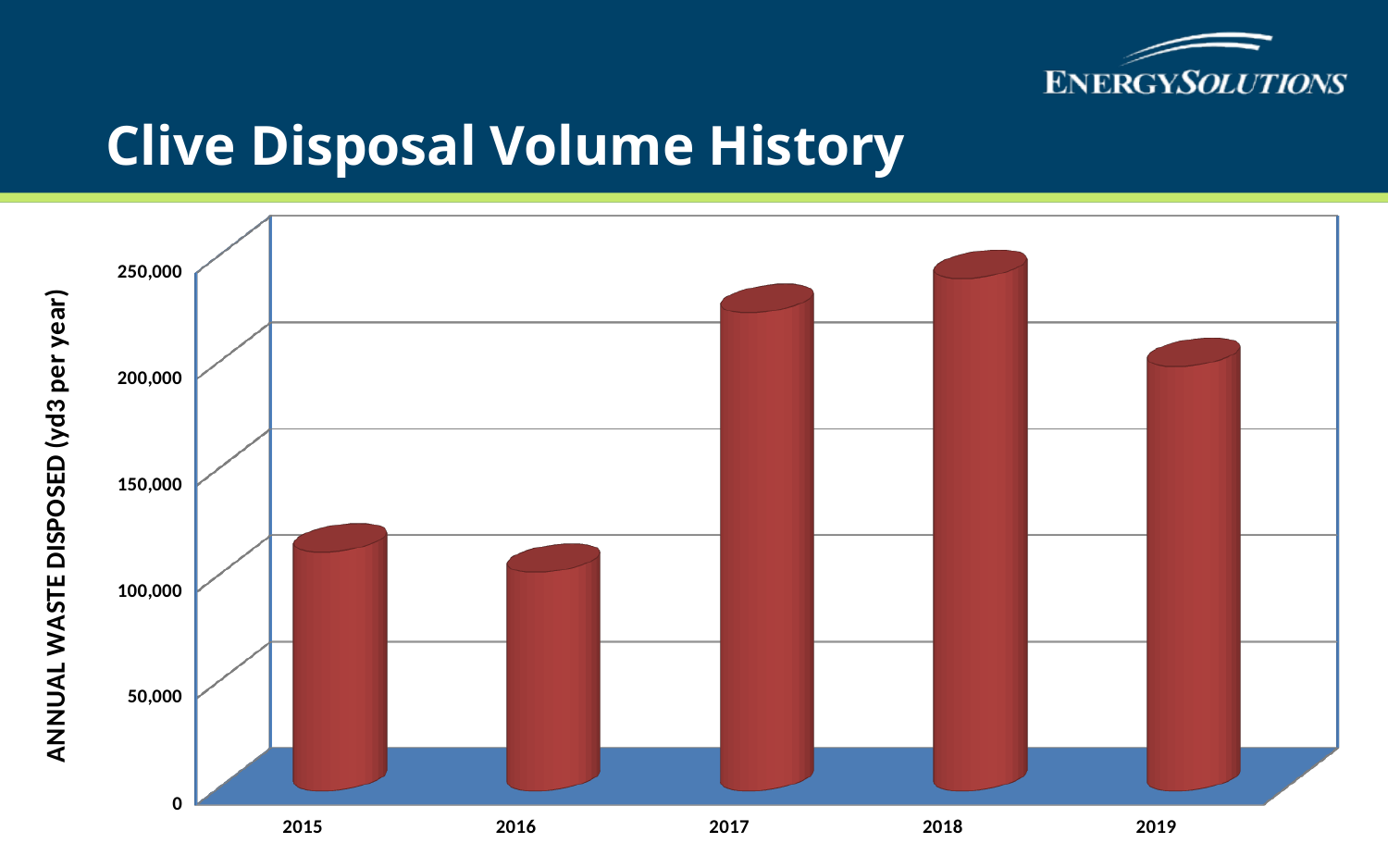
Is the value for 2019 greater or less than 150,000? greater Is the value for 2017 greater or less than 200,000? greater Did the annual waste disposed rise or fall from 2018 to 2019? fall What kind of chart is shown on the slide? bar chart Is the value for 2016 greater or less than 150,000? less Which year has the lowest annual waste disposed? 2016 Which year has the highest annual waste disposed? 2018 What is the label on the vertical axis of the chart? ANNUAL WASTE DISPOSED (yd3 per year) What is the title of the chart on the slide? Clive Disposal Volume History Which year has the larger annual waste disposed, 2017 or 2019? 2017 How many years are shown on the x axis of the chart? 5